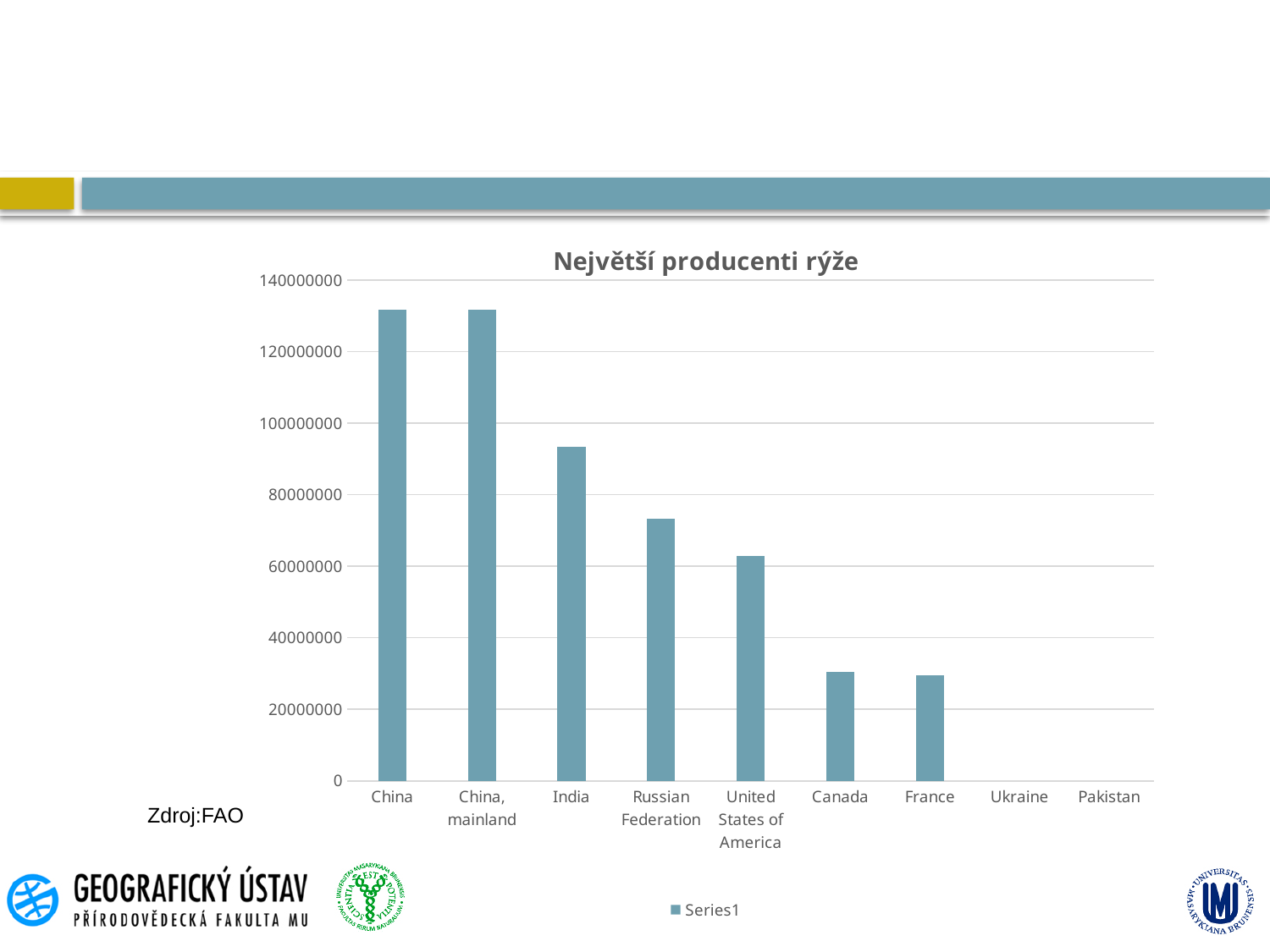
Is the value for India greater or less than 80000000? greater Which has a larger value, India or Russian Federation? India How many categories are shown on the x axis of the chart? 9 What is the name of the series shown in the legend? Series1 Is the value for Canada greater or less than 40000000? less What kind of chart is shown on the slide? bar chart Is the value for Russian Federation greater or less than 80000000? less What is the title of the chart? Největší producenti rýže How many series does the legend list? 1 Which has a larger value, United States of America or France? United States of America